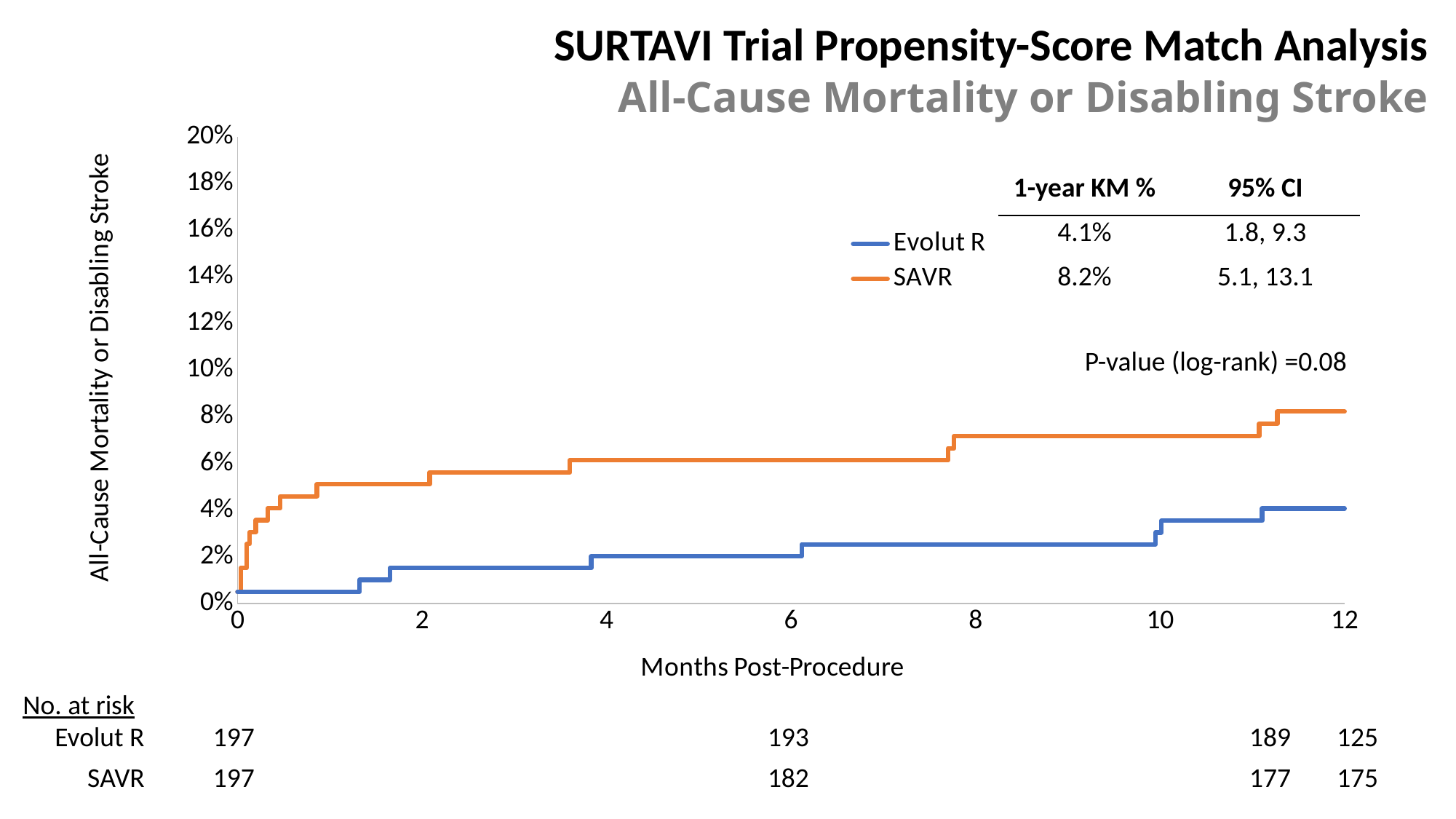
Do the curves rise or fall as months post-procedure increase? Rise What is the 1-year KM % for SAVR? 8.2% How many series does the legend list? 2 What is the 1-year KM % for Evolut R? 4.1% What is the 95% CI for SAVR? 5.1, 13.1 Is the value for SAVR at 6 months post-procedure greater or less than 4%? greater What is the number at risk for SAVR at month 0? 197 What kind of chart is shown on the slide? Line chart Is the value for Evolut R at 6 months post-procedure greater or less than 4%? less What is the log-rank P-value shown on the chart? 0.08 Which series has the higher 1-year KM %, Evolut R or SAVR? SAVR What is the difference between the 1-year KM % for SAVR and for Evolut R? 4.1 percentage points